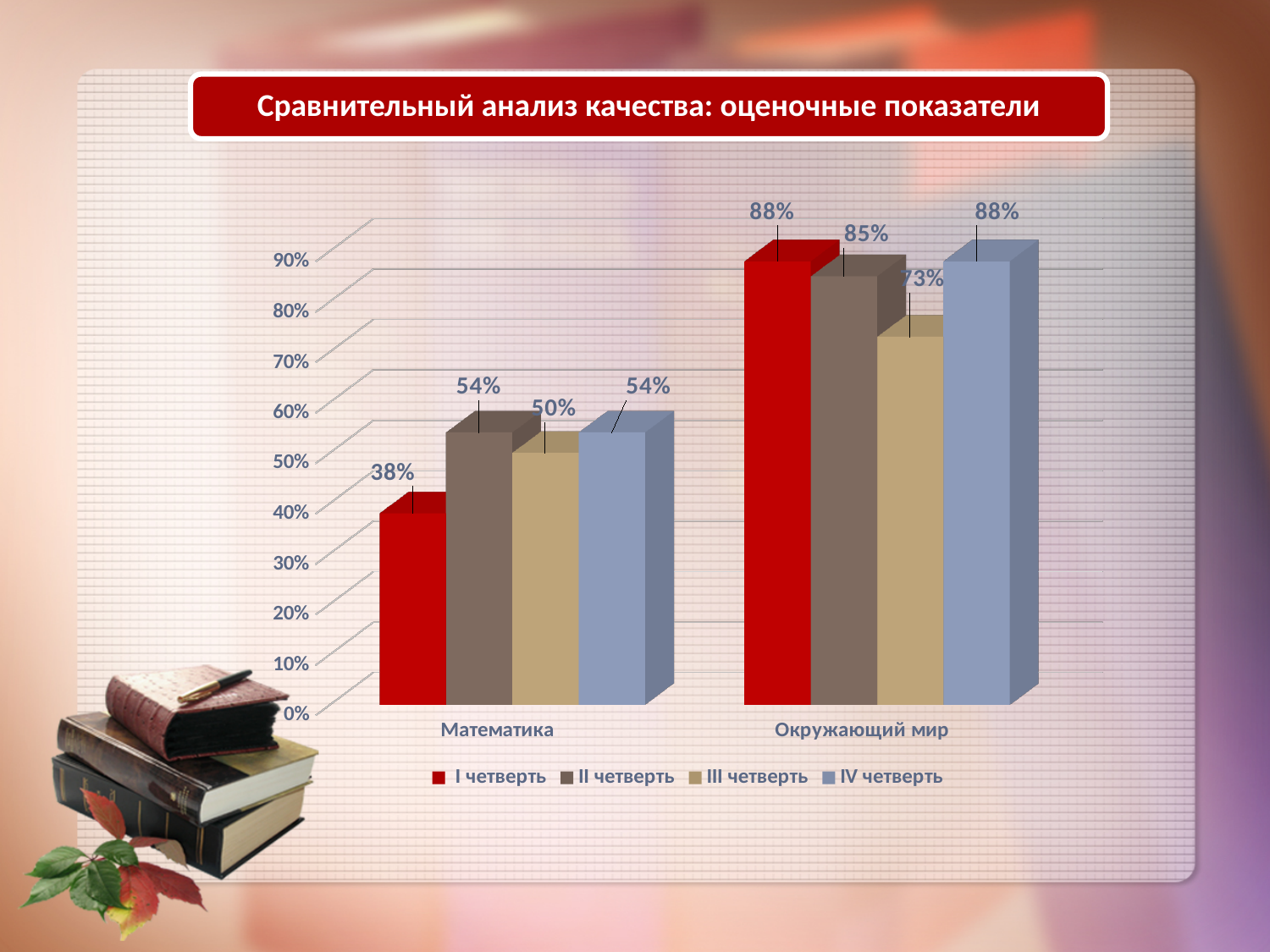
What is the value for I четверть in the Математика category? 38% How many series does the legend list? 4 What is the value for III четверть in the Окружающий мир category? 73% How many categories are shown on the x axis? 2 Which quarter has the lowest value in the Математика category? I четверть Which quarter has the lowest value in the Окружающий мир category? III четверть What is the difference between the II четверть and III четверть values in the Математика category? 4% What kind of chart is shown on the slide? Bar chart What is the difference between the I четверть values for Окружающий мир and Математика? 50% Which is larger: the III четверть value for Математика or the III четверть value for Окружающий мир? Окружающий мир What is the title of the slide? Сравнительный анализ качества: оценочные показатели What is the value for II четверть in the Окружающий мир category? 85%